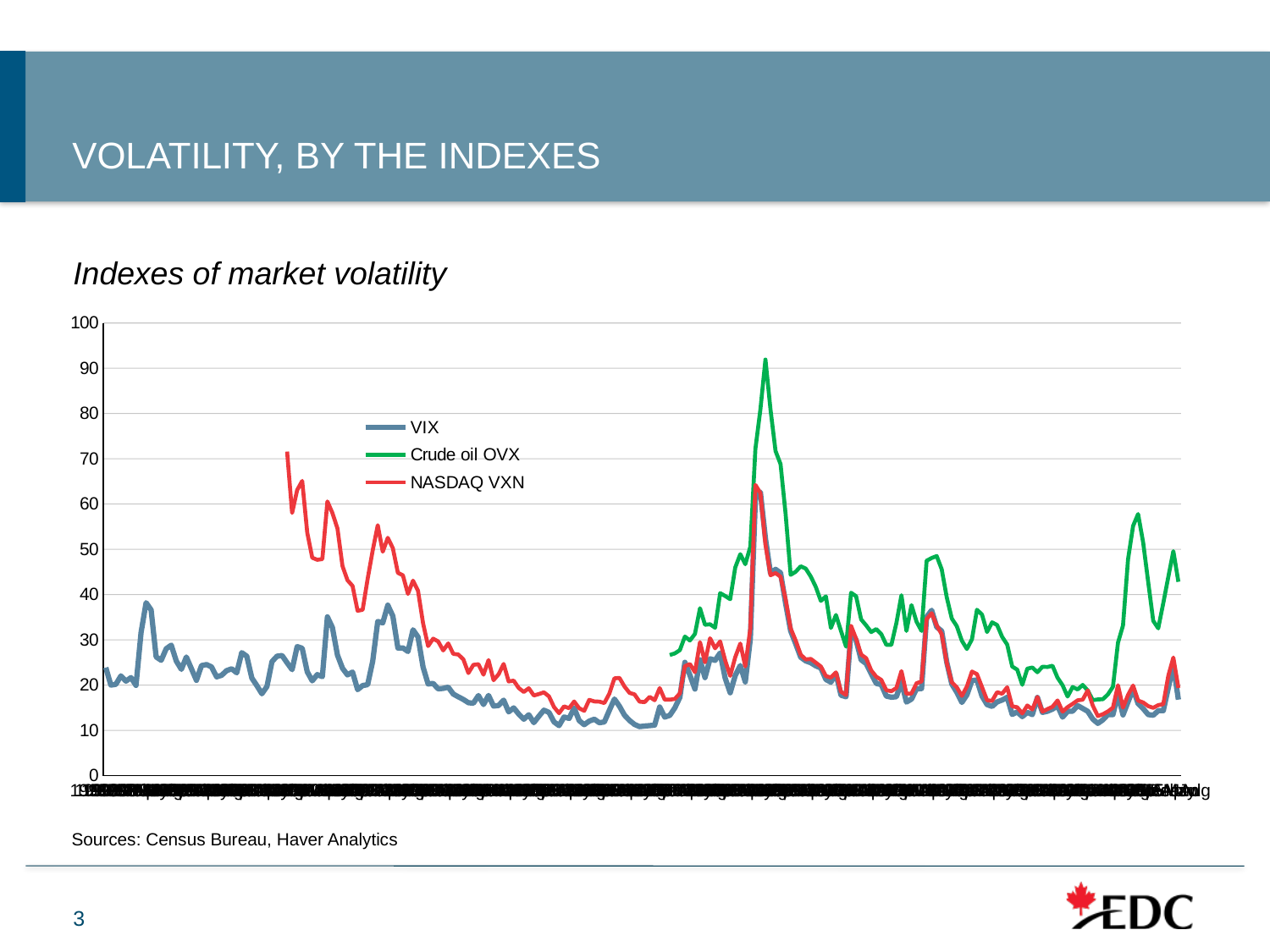
Is the first value of the NASDAQ VXN line at the left of the chart greater or less than 60? greater At the tallest spike in the middle of the chart, which is higher, Crude oil OVX or VIX? Crude oil OVX What is the subtitle of the chart? Indexes of market volatility Is the highest peak of the Crude oil OVX line greater or less than 80? greater What is the highest value shown on the vertical axis? 100 Is the highest peak of the VIX line greater or less than 70? less Which series is drawn in green? Crude oil OVX Does the NASDAQ VXN line rise or fall over the first portion of the chart after it starts? fall What kind of chart is shown on the slide? line chart How many series does the legend list? 3 Which series reaches the highest peak on the chart? Crude oil OVX